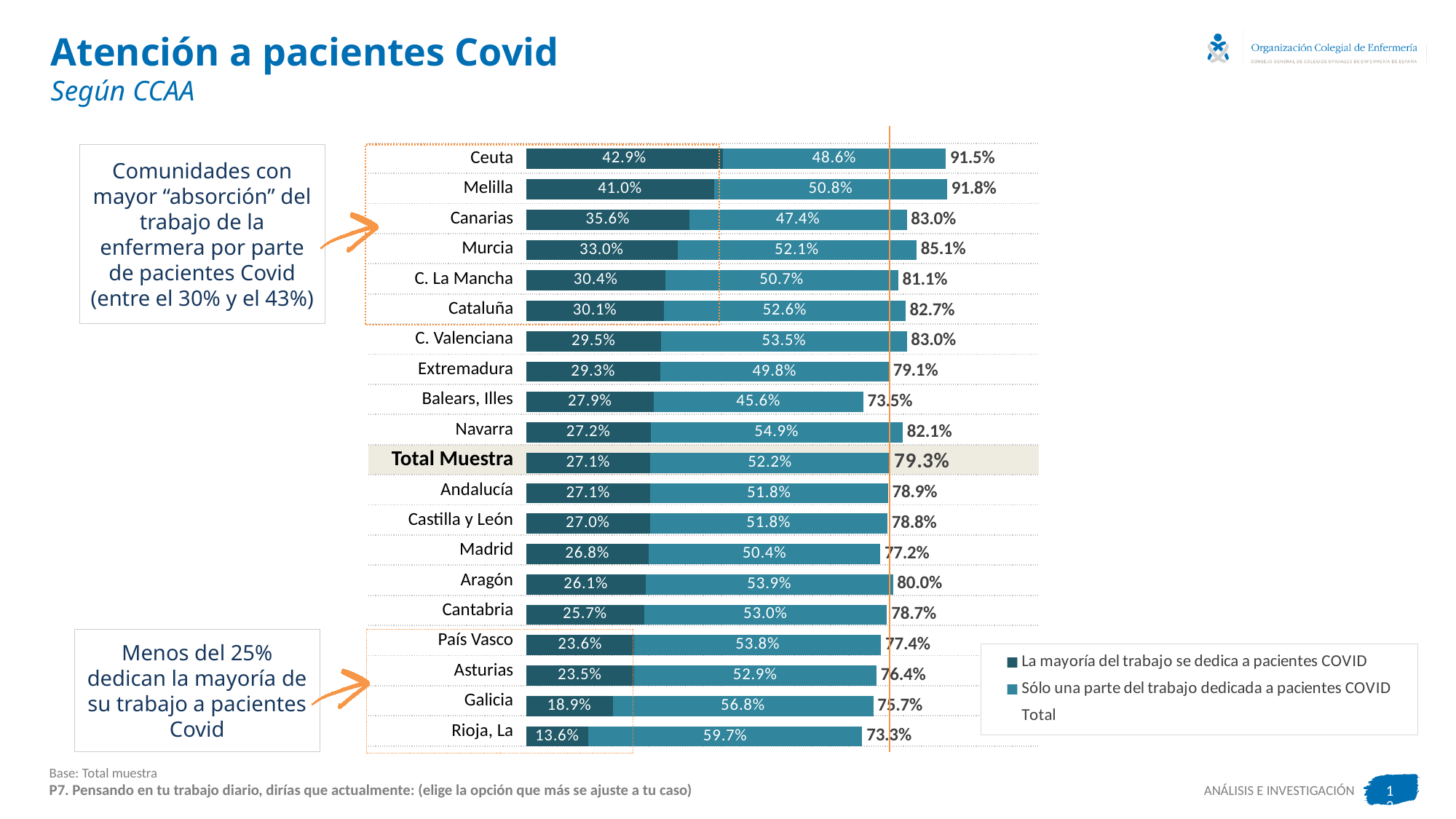
Which community has the highest value for 'La mayoría del trabajo se dedica a pacientes COVID'? Ceuta What is the Total value shown for 'Total Muestra'? 79.3% Which has a larger value for 'Sólo una parte del trabajo dedicada a pacientes COVID', Navarra or Madrid? Navarra What is the difference in percentage points between Ceuta and Rioja, La for 'La mayoría del trabajo se dedica a pacientes COVID'? 29.3 What percentage of nurses in Ceuta say the majority of their work is dedicated to COVID patients? 42.9% Which community has the highest Total value? Melilla How many entries does the legend list? 3 What is the value for 'Sólo una parte del trabajo dedicada a pacientes COVID' in Galicia? 56.8% How many categories (rows) are shown in the chart, including Total Muestra? 20 What is the Total value for Balears, Illes? 73.5% Which community has the lowest value for 'La mayoría del trabajo se dedica a pacientes COVID'? Rioja, La What kind of chart is shown on the slide? Stacked bar chart